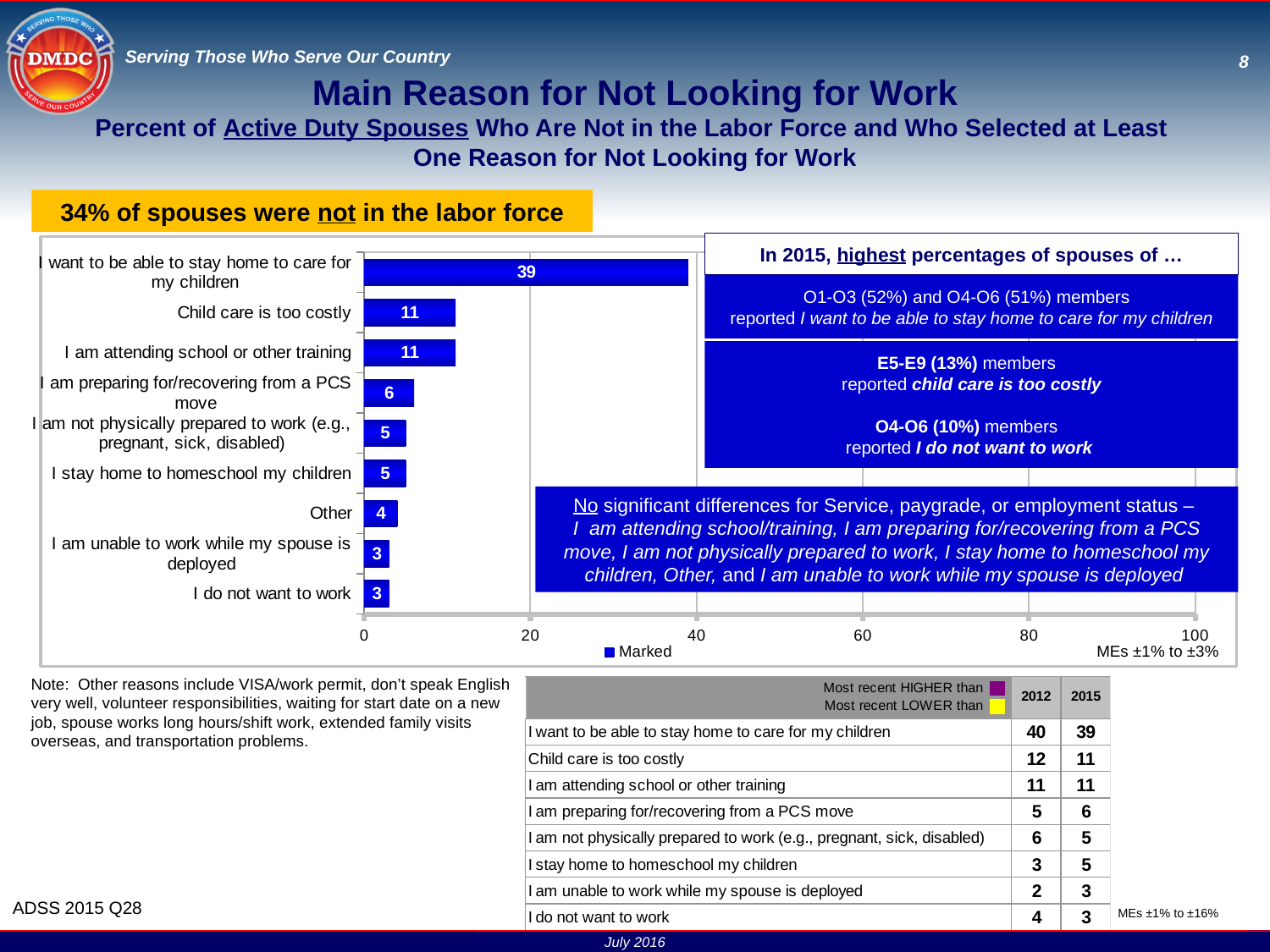
What percentage of spouses selected "I want to be able to stay home to care for my children" as a reason for not looking for work? 39 What is the legend entry for the series in the chart? Marked How many series does the chart legend list? 1 Which reason has the highest percentage in the chart? I want to be able to stay home to care for my children What value is shown for "Other"? 4 What value is shown for "Child care is too costly"? 11 What is the difference between the value for "I want to be able to stay home to care for my children" and the value for "Child care is too costly"? 28 How many reasons (categories) are plotted in the bar chart? 9 Which is larger: the value for "I am preparing for/recovering from a PCS move" or the value for "I do not want to work"? I am preparing for/recovering from a PCS move What value is shown for "I am preparing for/recovering from a PCS move"? 6 What kind of chart is shown on the slide? bar chart Is the value for "I want to be able to stay home to care for my children" greater or less than 20? greater